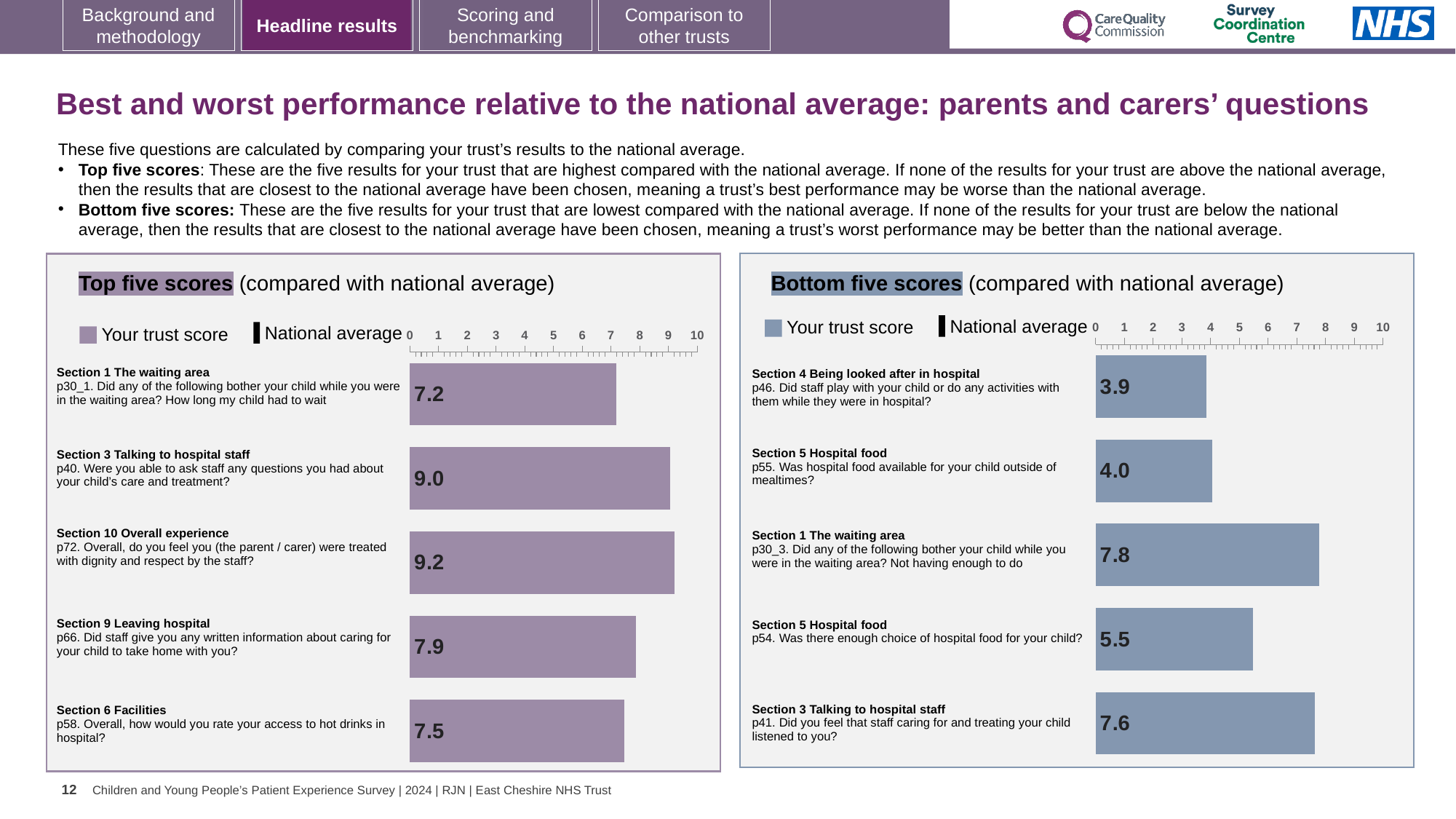
In the Top five scores chart, which has the larger trust score: p66 (written information about caring for your child) or p58 (access to hot drinks in hospital)? p66 How many series does the legend of the Top five scores chart list? 2 In the Bottom five scores chart, which question has the lowest trust score? p46. Did staff play with your child or do any activities with them while they were in hospital? In the Bottom five scores chart, what is the trust score for p54 (Was there enough choice of hospital food for your child)? 5.5 In the Bottom five scores chart, what is the difference between the score for p30_3 (7.8) and the score for p46 (3.9)? 3.9 How many questions are shown in the Bottom five scores chart? 5 In the Top five scores chart, what is the difference between the highest score (9.2) and the lowest score (7.2)? 2.0 In the Top five scores chart, what is the trust score for p40 (Were you able to ask staff any questions you had about your child's care and treatment)? 9.0 What kind of chart is the Top five scores chart? Bar chart In the Bottom five scores chart, is the trust score for p55 (hospital food available outside of mealtimes) greater or less than 5? less What are the two legend entries in the Bottom five scores chart? Your trust score; National average In the Top five scores chart, which question has the highest trust score? p72. Overall, do you feel you (the parent / carer) were treated with dignity and respect by the staff?